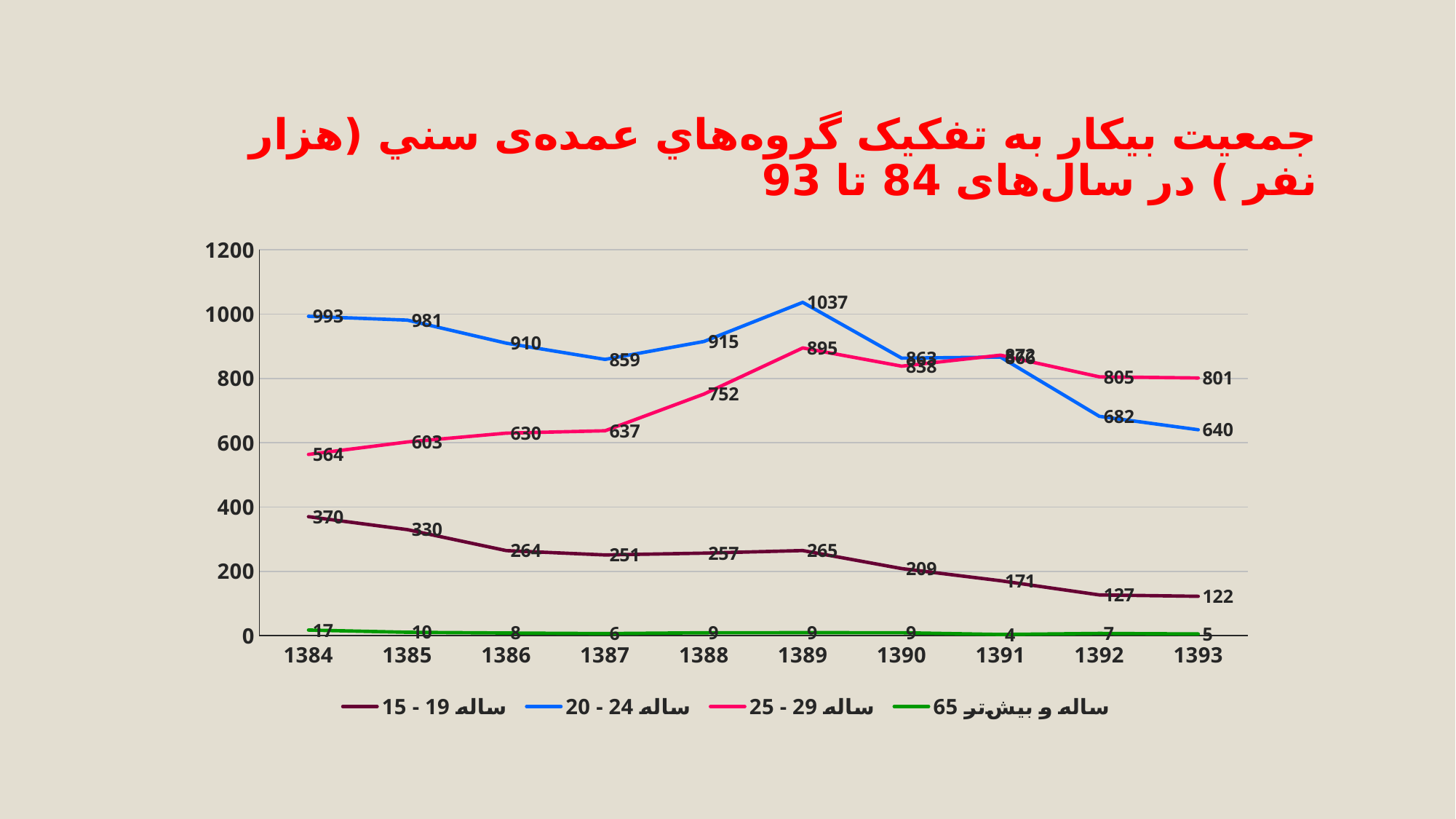
In which year is the 15 - 19 ساله series at its lowest? 1393 How many series does the legend list? 4 Does the 15 - 19 ساله series generally rise or fall from 1384 to 1393? fall Which is larger in 1393: the 25 - 29 ساله value or the 20 - 24 ساله value? 25 - 29 ساله What is the difference between the 20 - 24 ساله value in 1384 and in 1393? 353 How many years are shown on the x axis? 10 What is the value for the 25 - 29 ساله series in 1384? 564 What is the value for the 20 - 24 ساله series in 1389? 1037 In which year does the 20 - 24 ساله series reach its highest value? 1389 What kind of chart is shown on the slide? line chart What is the value for the 15 - 19 ساله series in 1393? 122 What is the value for the 65 ساله و بیشتر series in 1391? 4